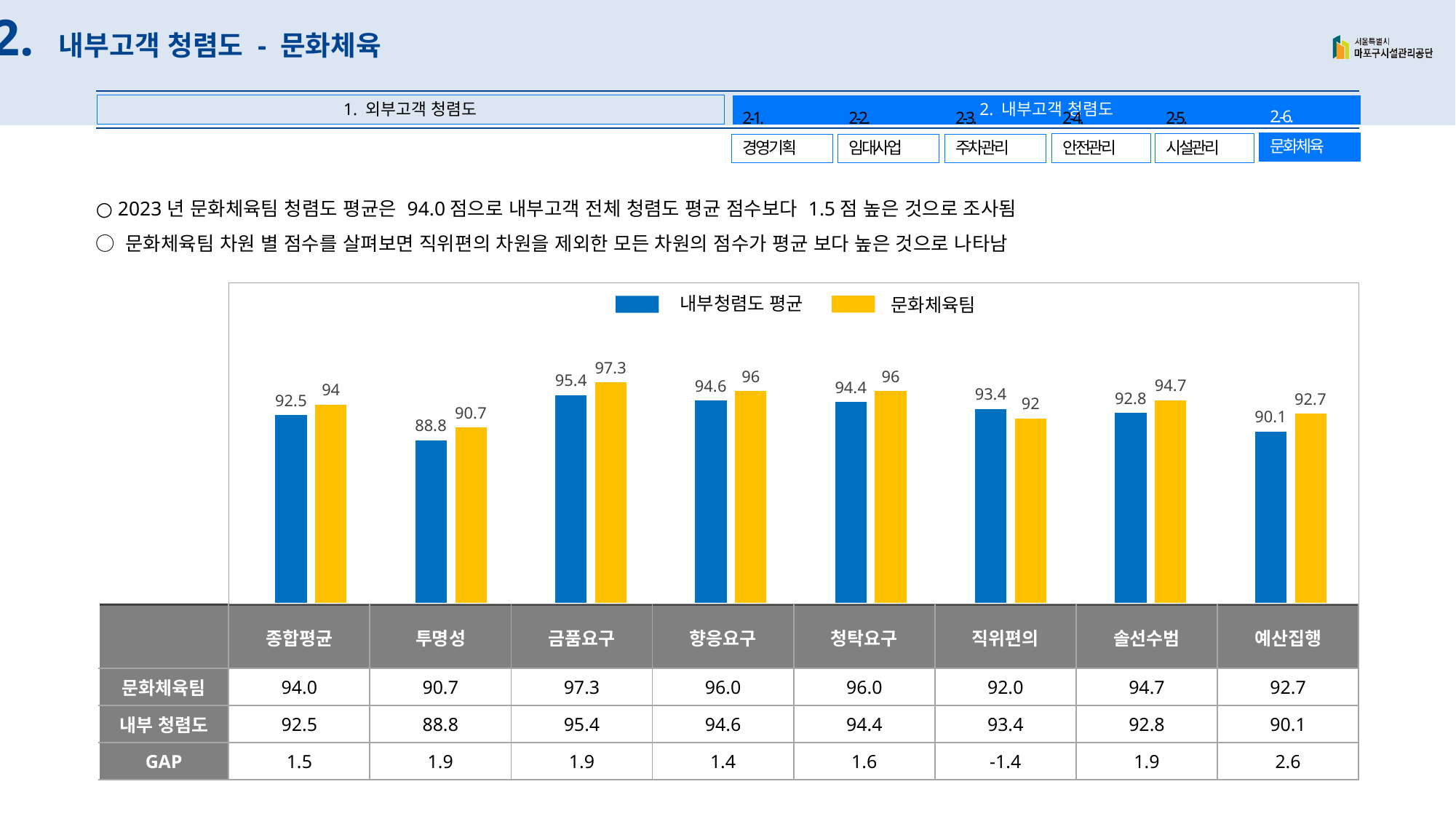
Which category has the highest value for the 문화체육팀 series? 금품요구 How many series does the chart legend list? 2 In the 직위편의 category, which series has the larger value, 내부청렴도 평균 or 문화체육팀? 내부청렴도 평균 What is the value for 문화체육팀 in the 직위편의 category? 92 What is the difference between the 문화체육팀 and 내부청렴도 평균 values in the 예산집행 category? 2.6 What type of chart is shown on the slide? Bar chart What is the value for 문화체육팀 in the 금품요구 category? 97.3 Which colour represents the 문화체육팀 series in the chart? Yellow Which category has the lowest value for the 내부청렴도 평균 series? 투명성 How many categories are shown on the x axis of the chart? 8 What is the value for 내부청렴도 평균 in the 투명성 category? 88.8 What is the value for 내부청렴도 평균 in the 종합평균 category? 92.5